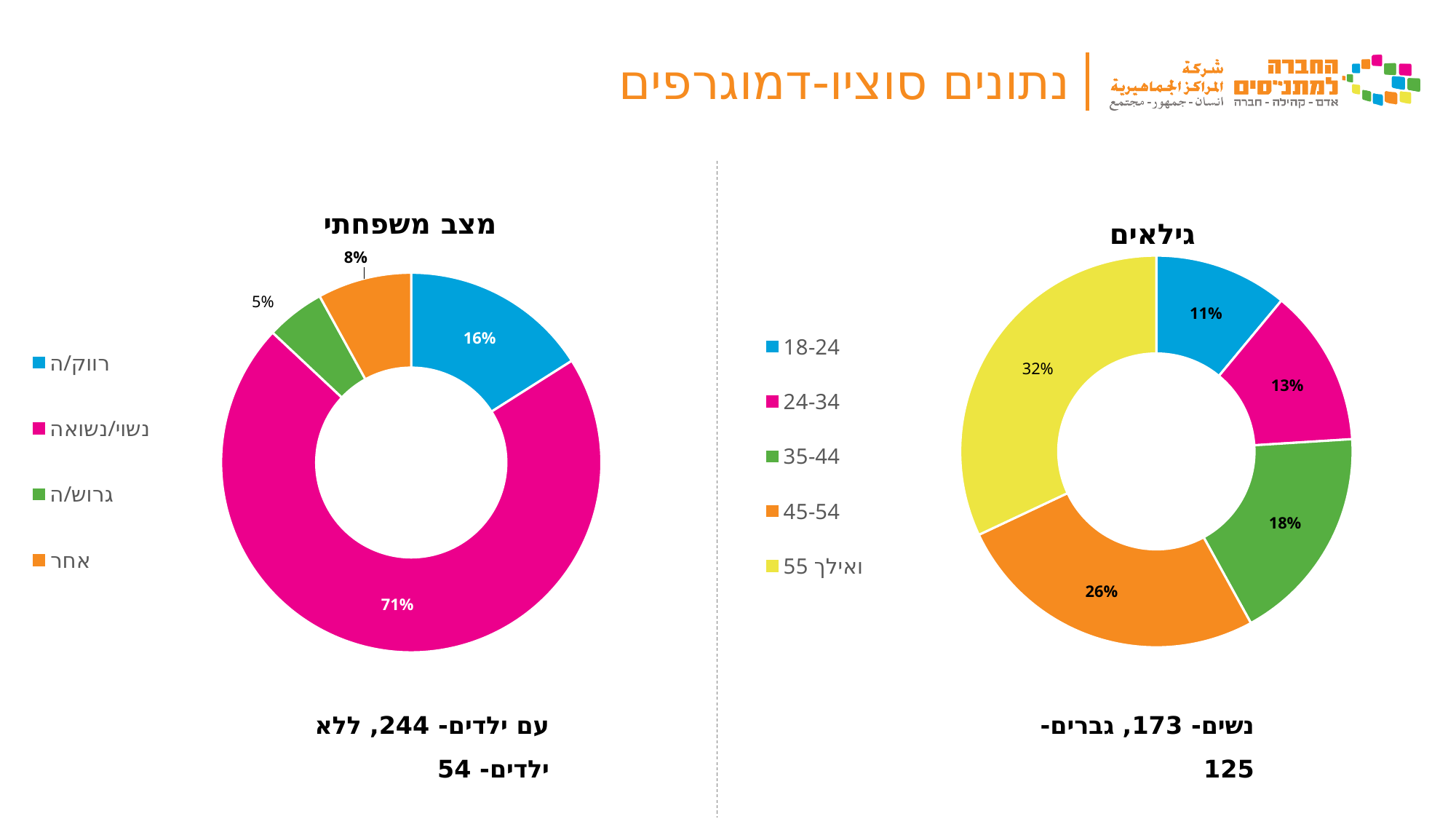
In the 'גילאים' chart, how many age groups does the legend list? 5 In the 'גילאים' chart, what percentage is shown for the 18-24 age group? 11% In the 'גילאים' chart, what is the difference in percentage points between the 35-44 and 24-34 age groups? 5 In the 'גילאים' chart, which age group has the smallest share? 18-24 In the 'גילאים' chart, which age group has the largest share? 55 ואילך What type of chart is used for 'מצב משפחתי'? Donut (pie) chart In the 'גילאים' chart, what percentage is shown for the 45-54 age group? 26% In the 'מצב משפחתי' chart, what percentage is shown for נשוי/נשואה? 71% In the 'מצב משפחתי' chart, which is larger: the share for רווק/ה or the share for אחר? רווק/ה In the 'מצב משפחתי' chart, what percentage is shown for אחר? 8% In the 'מצב משפחתי' chart, what is the difference in percentage points between נשוי/נשואה and רווק/ה? 55 In the 'מצב משפחתי' chart, which category has the smallest share? גרוש/ה